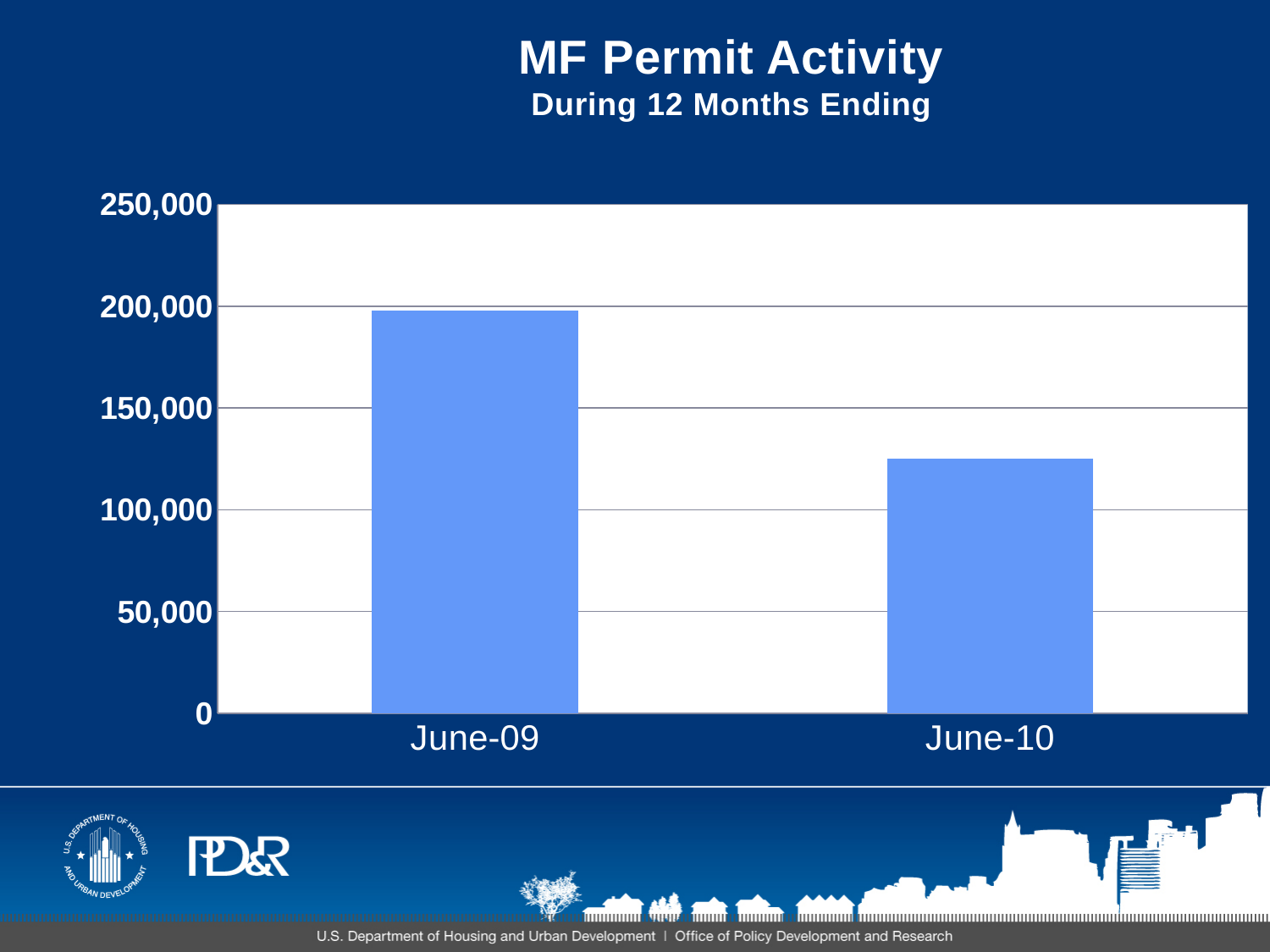
What kind of chart is shown on the slide? bar chart Is the value for June-10 greater or less than 150,000? less Is the value for June-09 greater or less than 150,000? greater What is the highest value shown on the vertical axis? 250,000 Do the values rise or fall from June-09 to June-10? fall What is the title of the chart? MF Permit Activity Is the value for June-10 greater or less than 100,000? greater Which period has the higher MF permit activity, June-09 or June-10? June-09 Which category has the lowest value in the chart? June-10 Which category has the highest value in the chart? June-09 How many bars are plotted in the chart? 2